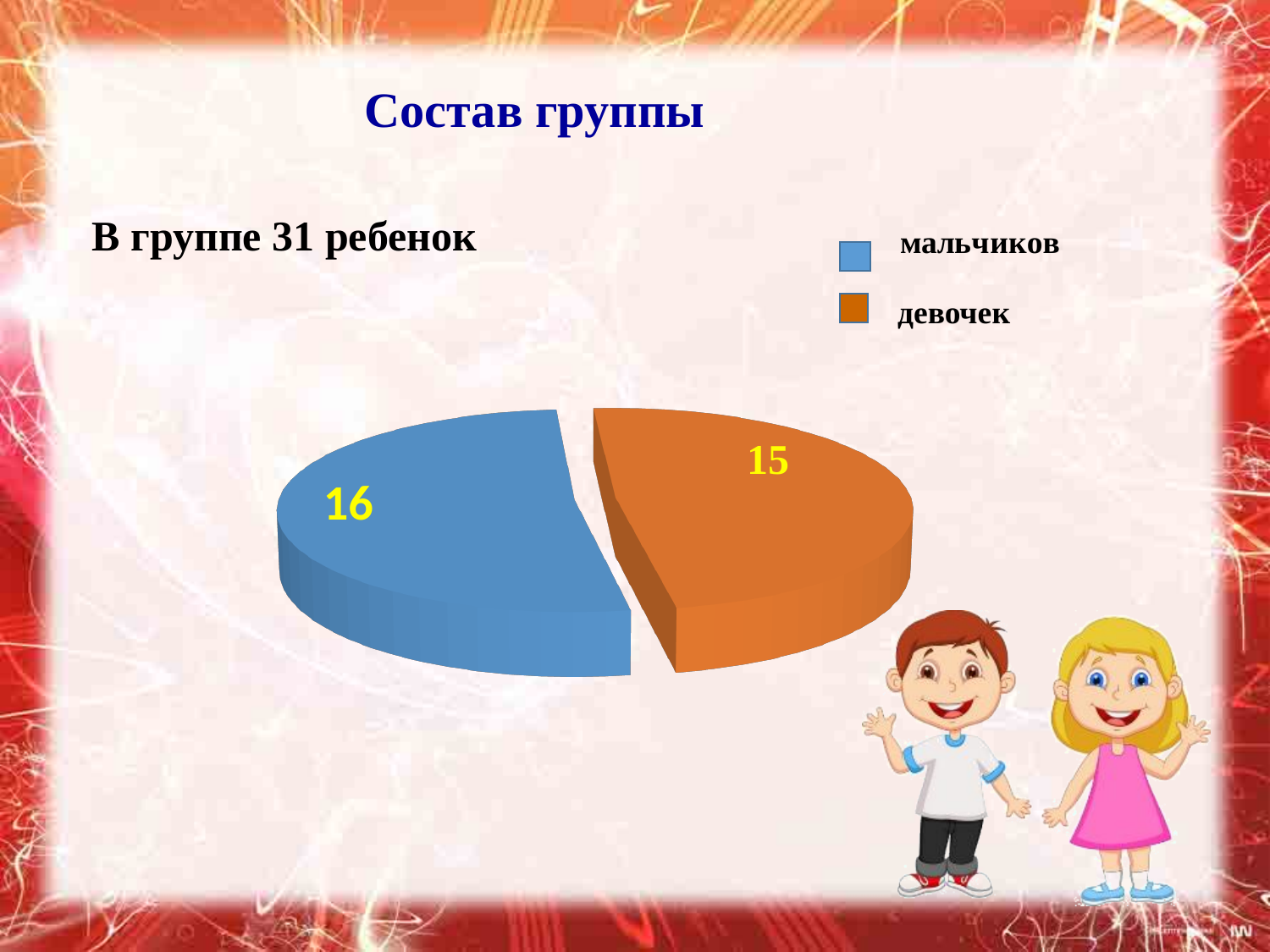
How many entries does the legend list? 2 What is the difference between the number of boys and the number of girls in the pie chart? 1 What kind of chart is shown on the slide? pie chart Which category has the larger slice in the pie chart? мальчиков Is the value for мальчиков larger or smaller than the value for девочек? larger What is the title of the slide with the pie chart? Состав группы How many girls (девочек) are shown in the pie chart? 15 What colour is the slice for девочек in the pie chart? orange How many boys (мальчиков) are shown in the pie chart? 16 What is the total of the two slices in the pie chart? 31 Which category has the smaller slice in the pie chart? девочек How many slices does the pie chart have? 2